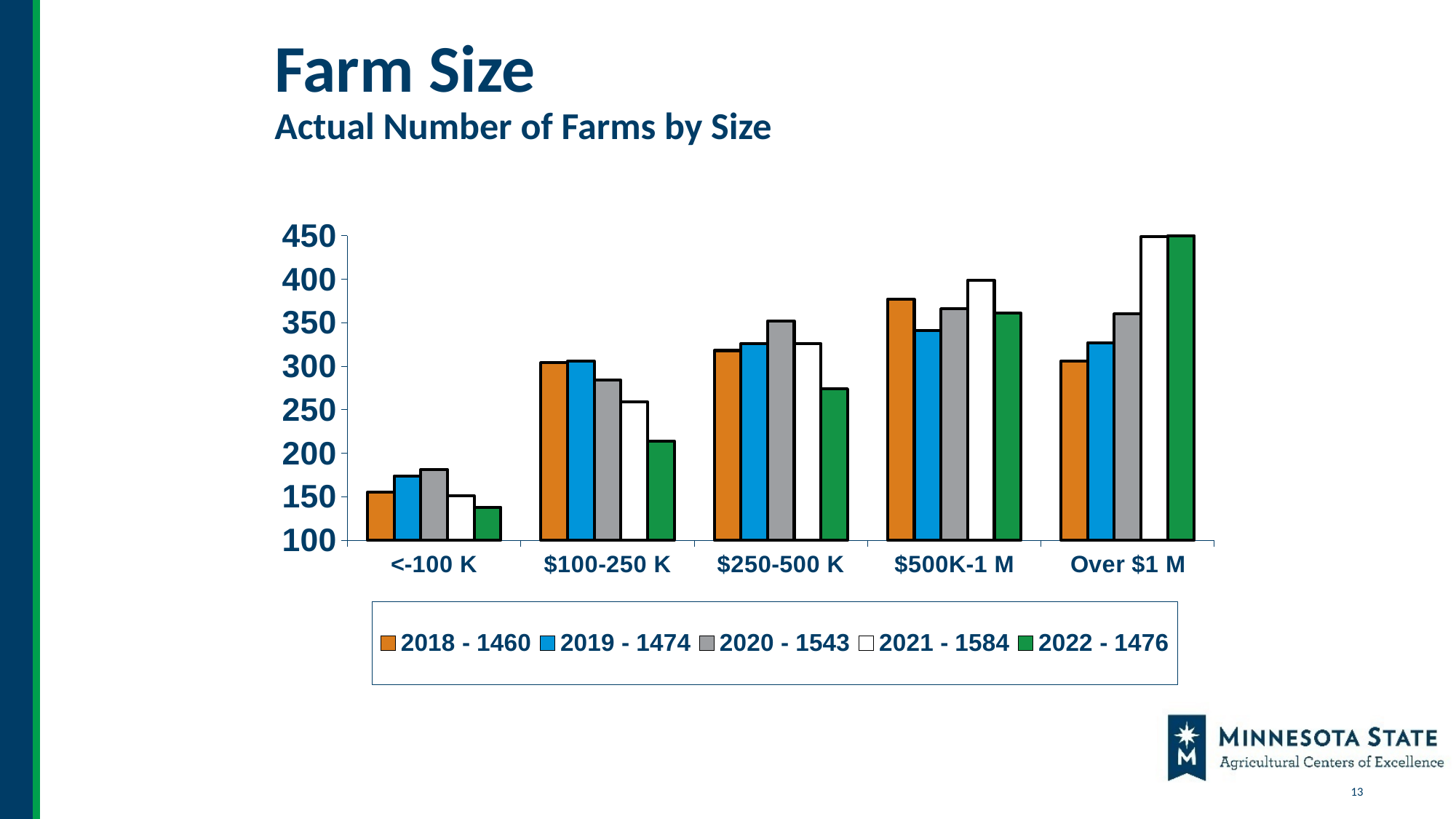
How many farm size categories are shown on the x axis? 5 In the $100-250 K category, which is larger: the 2018 value or the 2022 value? 2018 Is the value for 2022 in the $100-250 K category greater or less than 200? greater Which year has the highest value in the $500K-1 M category? 2021 - 1584 Do the 2022 values rise or fall as farm size increases from <-100 K to Over $1 M? rise Which year has the highest value in the $250-500 K category? 2020 - 1543 Which year has the lowest value in the <-100 K category? 2022 - 1476 Which year has the lowest value in the $100-250 K category? 2022 - 1476 Is the value for 2018 in the $500K-1 M category greater or less than 400? less What total is shown next to 2021 in the legend? 1584 How many series does the legend list? 5 What kind of chart is shown on the slide? bar chart